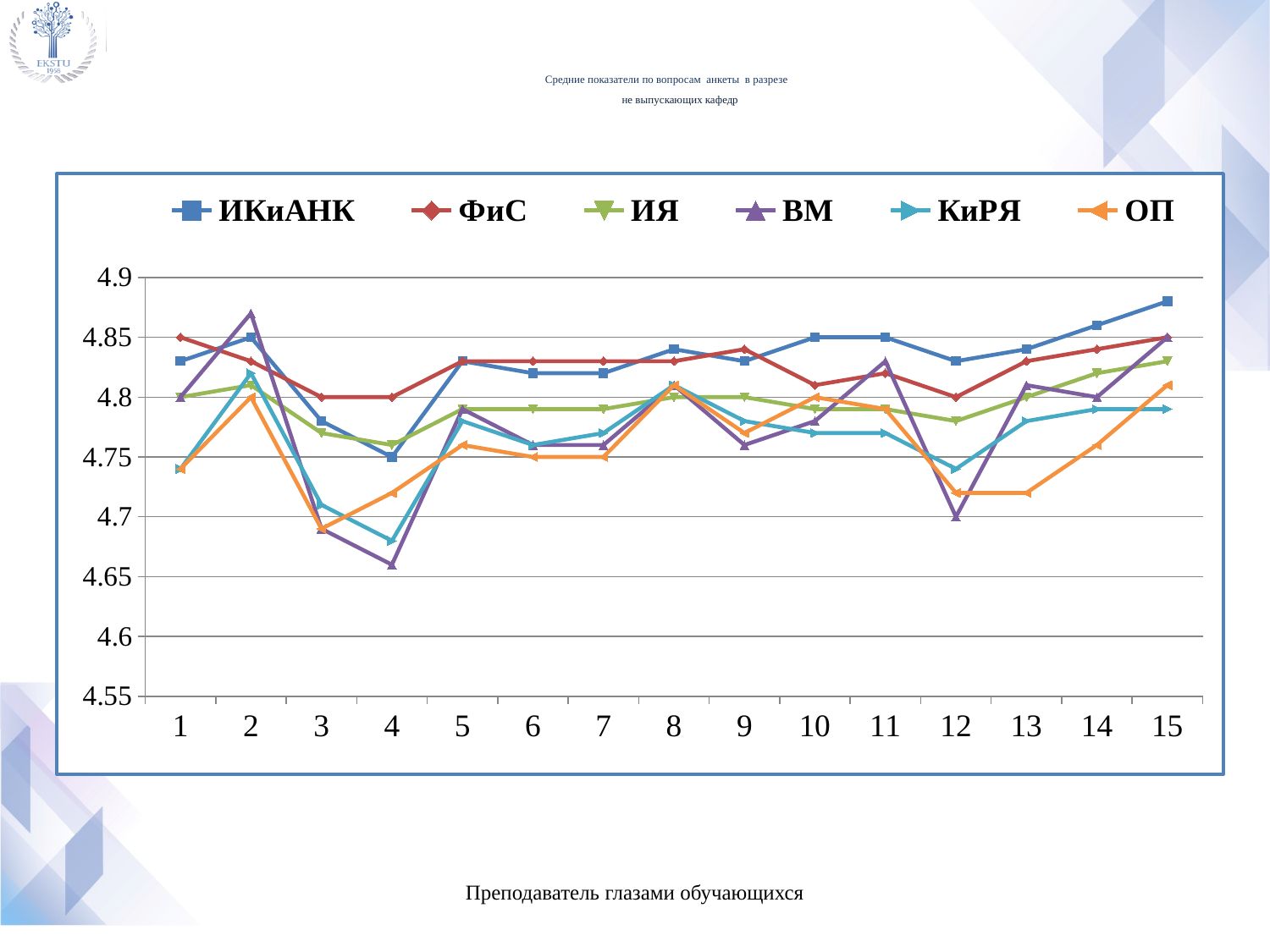
Which series has the highest value at point 4? ФиС At point 12, which is larger: ИКиАНК or ВМ? ИКиАНК Is the value for ВМ at point 2 greater or less than 4.85? greater How many series does the legend list? 6 Is the value for ВМ at point 4 greater or less than 4.7? less What kind of chart is shown on the slide? line chart Which series has the highest value at point 15? ИКиАНК How many points are there along the x axis? 15 Is the value for ИКиАНК at point 15 greater or less than 4.85? greater Which series has the lowest value at point 4? ВМ Does the ИКиАНК series rise or fall from point 12 to point 15? rise